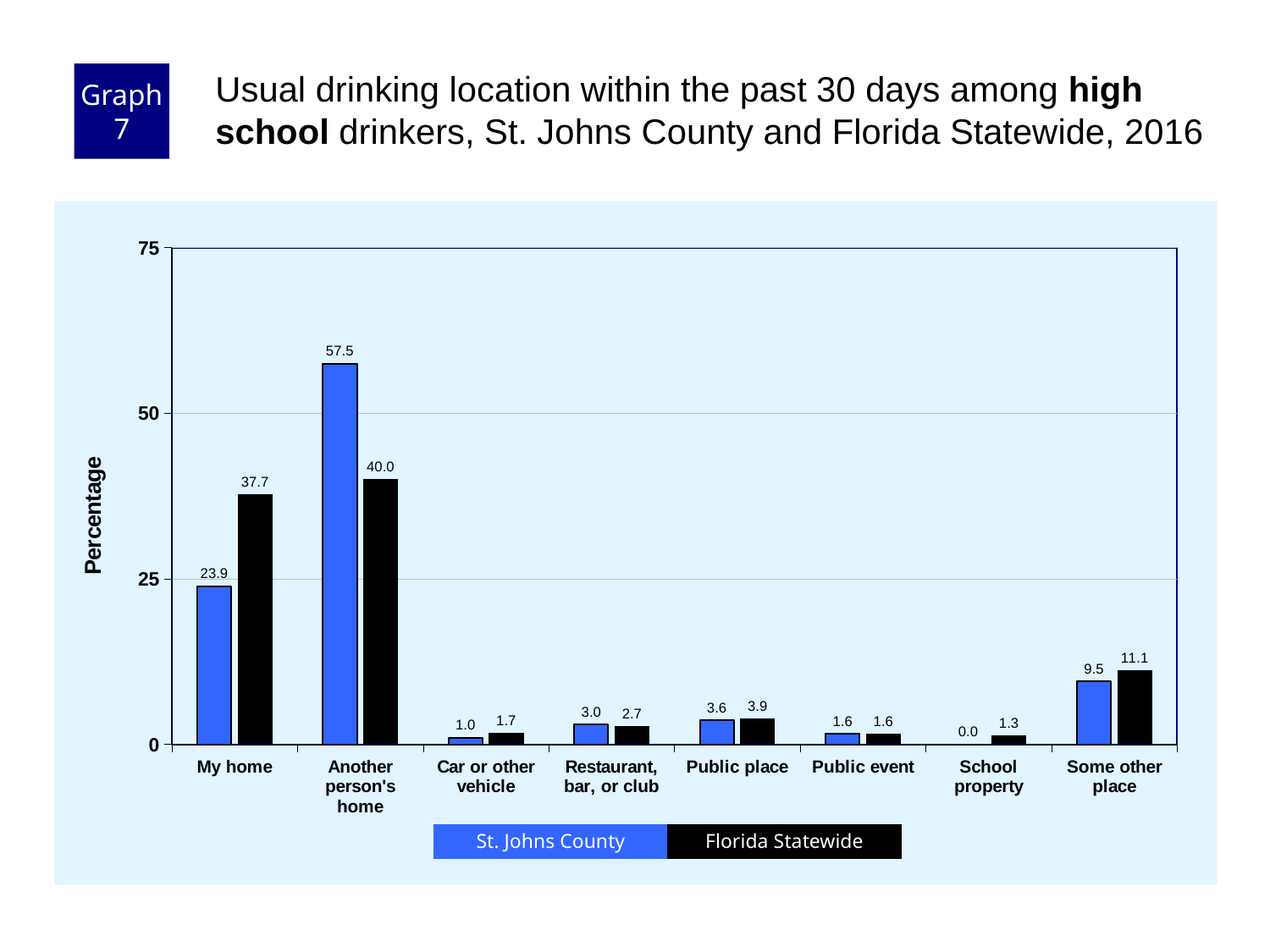
How many series does the legend list? 2 What is the label on the y axis? Percentage What is the St. Johns County value for "Another person's home"? 57.5 Which category has the highest St. Johns County value? Another person's home What kind of chart is shown on the slide? Bar chart How many location categories are shown on the x axis? 8 Is the St. Johns County value for "Another person's home" greater or less than 50? greater What is the Florida Statewide value for "My home"? 37.7 Which is larger for "My home": St. Johns County or Florida Statewide? Florida Statewide What is the St. Johns County value for "School property"? 0.0 Which category has the lowest Florida Statewide value? School property What is the difference between the St. Johns County and Florida Statewide values for "Another person's home"? 17.5